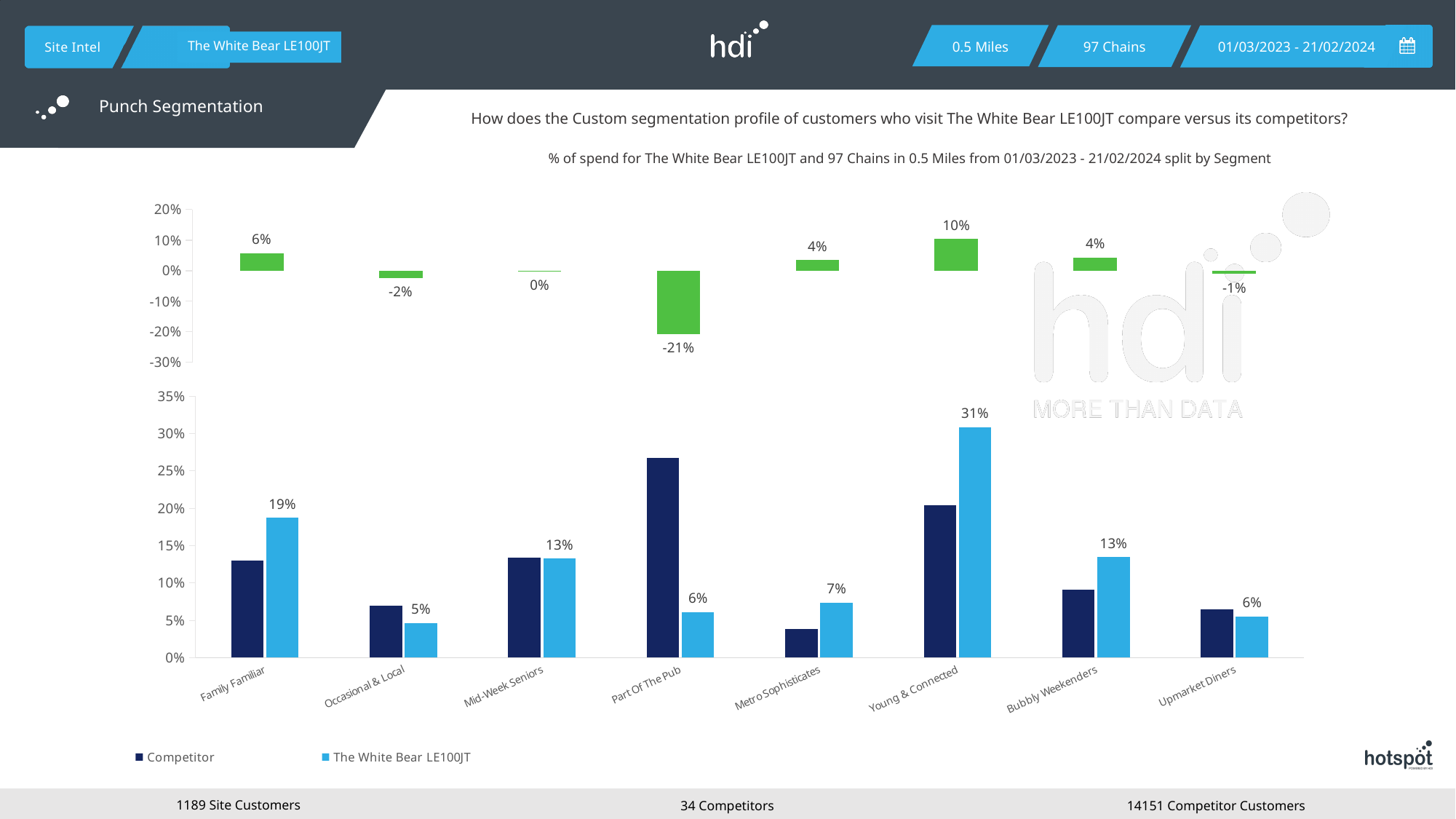
In the bottom chart, which segment has the highest value for The White Bear LE100JT? Young & Connected In the top chart, which segment has the highest value? Young & Connected In the bottom chart, is the Competitor value for Part Of The Pub greater or less than 25%? greater How many series does the legend of the bottom chart list? 2 In the bottom chart, is the Competitor value for Metro Sophisticates greater or less than 5%? less In the top chart, which segment has the lowest value? Part Of The Pub How many segments are shown on the x axis of the bottom chart? 8 In the bottom chart, what is the difference between The White Bear LE100JT values for Young & Connected and Family Familiar? 12% In the top chart, what is the value shown for Part Of The Pub? -21% In the bottom chart, what is the value for The White Bear LE100JT in the Family Familiar segment? 19% In the bottom chart, what is the value for The White Bear LE100JT in the Young & Connected segment? 31% In the bottom chart, which is larger for Part Of The Pub: the Competitor value or The White Bear LE100JT value? Competitor